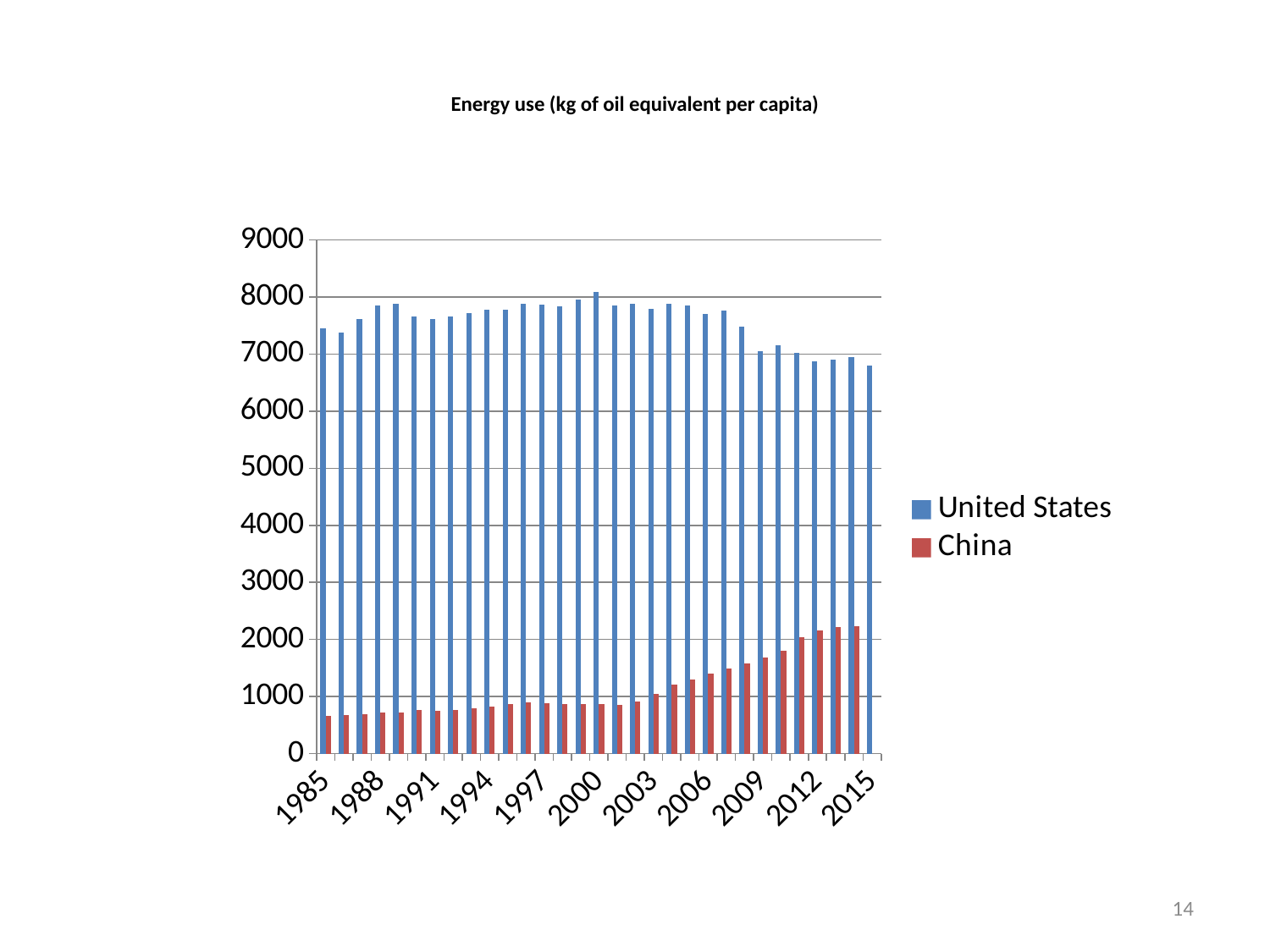
Do the values for the United States rise or fall from 2000 to 2015? fall What kind of chart is shown on the slide? bar chart Which series is shown in red? China What is the title of the chart? Energy use (kg of oil equivalent per capita) Is the value for the United States in 1985 greater or less than 7000? greater Is the value for China in 2009 greater or less than 1000? greater Do the values for China rise or fall from 1985 to 2015? rise Is the value for the United States in 2015 greater or less than 7000? less How many series does the legend list? 2